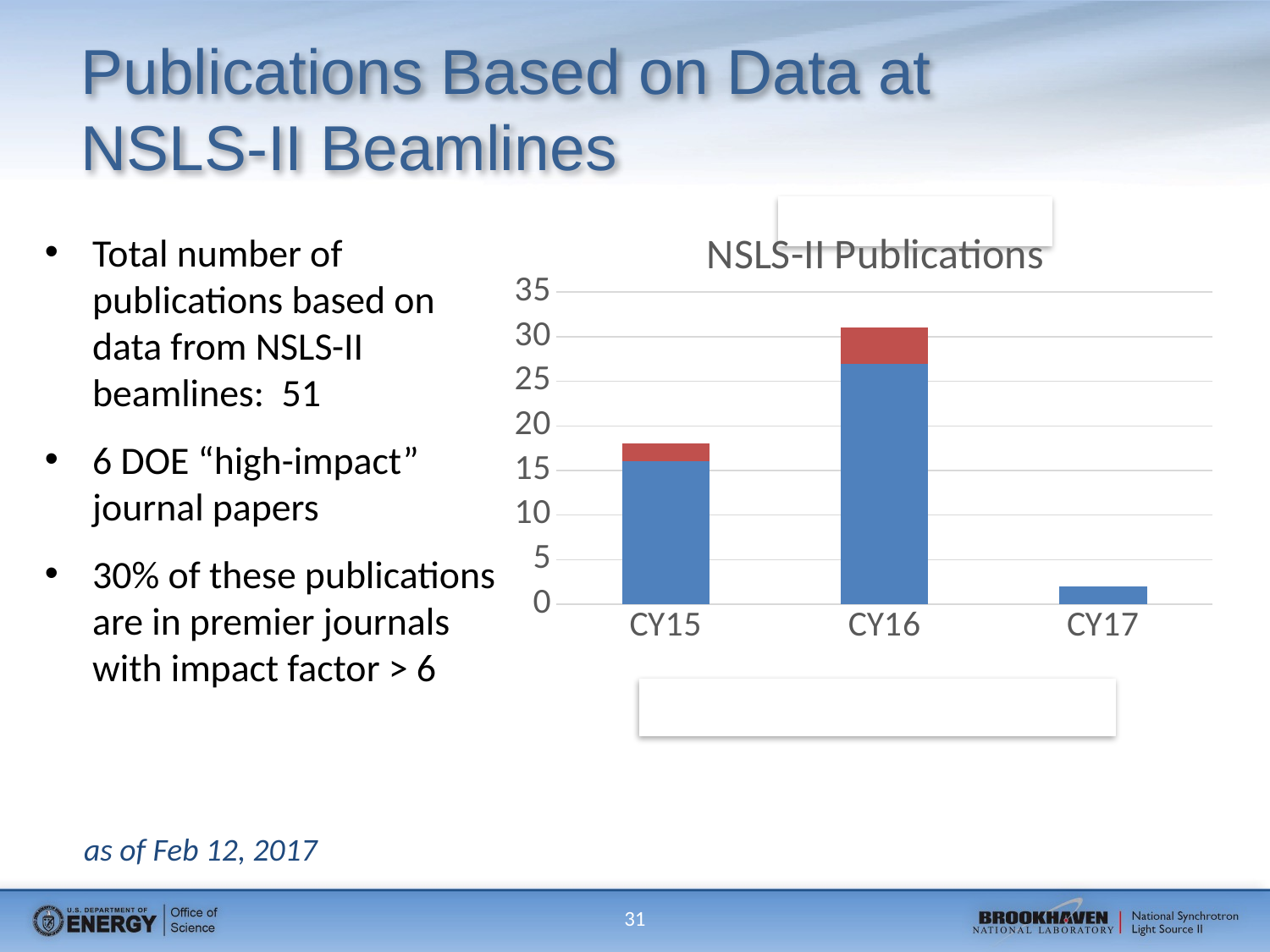
Is the total bar height for CY16 greater or less than 25? greater Is the total bar height for CY17 greater or less than 5? less How many categories are shown on the x axis of the chart? 3 What colour is the lower (larger) segment of each stacked bar? blue Which category has the shortest bar in the chart? CY17 Is the total bar height for CY15 greater or less than 20? less What type of chart is shown on the slide? bar chart Which bar is taller, CY15 or CY16? CY16 Does the total bar height rise or fall from CY15 to CY16? rise Which category has the tallest bar in the chart? CY16 What is the title of the chart? NSLS-II Publications